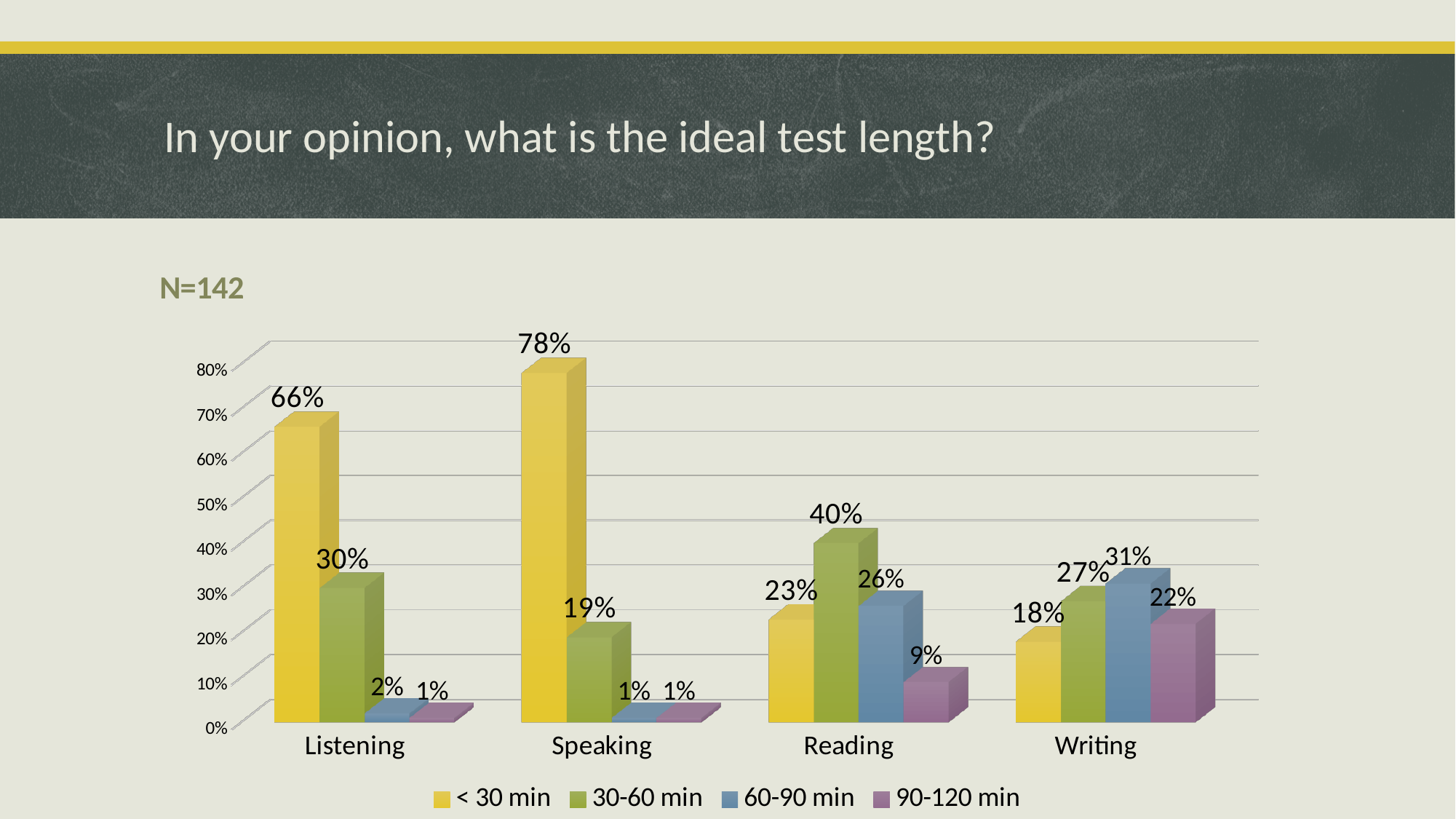
How many categories are shown on the x axis? 4 Is the value for '< 30 min' in Listening greater or less than 60%? greater How many series does the legend list? 4 What sample size (N) is stated above the chart? N=142 What is the value for '90-120 min' in the Writing category? 22% What kind of chart is shown on the slide? bar chart What is the value for '30-60 min' in the Reading category? 40% What is the difference between the '< 30 min' values for Speaking and Listening? 12% Which is larger in the Writing category: '60-90 min' or '30-60 min'? 60-90 min Which category has the highest value for the '< 30 min' series? Speaking What percentage of respondents chose '< 30 min' as the ideal test length for Speaking? 78%